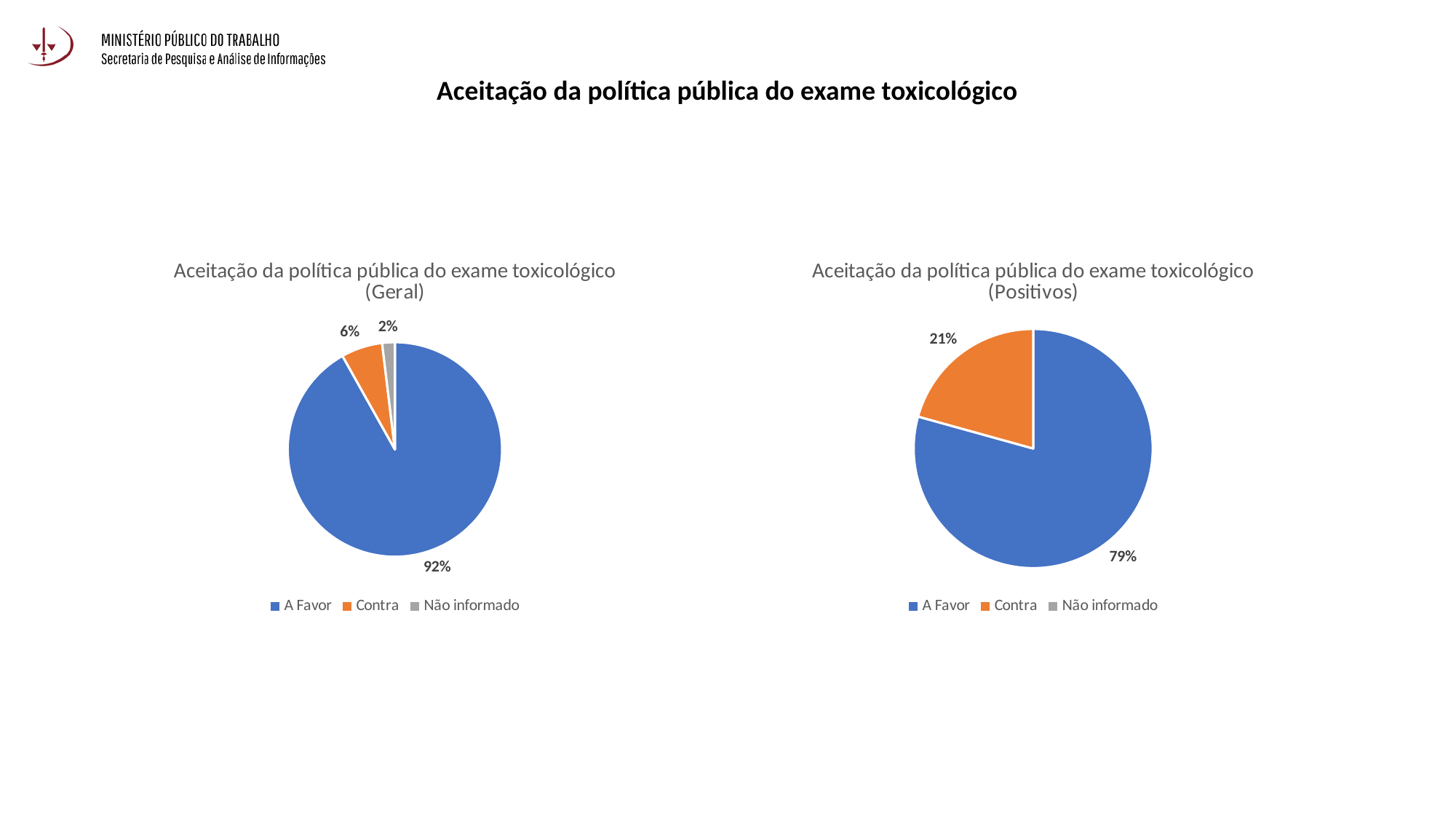
In the 'Aceitação da política pública do exame toxicológico (Positivos)' chart, what is the difference between the A Favor and Contra shares? 58% In the 'Aceitação da política pública do exame toxicológico (Geral)' chart, what share is labelled for Não informado? 2% In the 'Aceitação da política pública do exame toxicológico (Positivos)' chart, what share is labelled for Contra? 21% In the 'Aceitação da política pública do exame toxicológico (Geral)' chart, what share is labelled for Contra? 6% What kind of chart is the 'Aceitação da política pública do exame toxicológico (Geral)' chart? Pie chart How many entries does the legend of the 'Aceitação da política pública do exame toxicológico (Positivos)' chart list? 3 In the 'Aceitação da política pública do exame toxicológico (Geral)' chart, what share is labelled for A Favor? 92% Is the Contra share larger in the (Geral) chart or in the (Positivos) chart? Positivos What is the difference between the A Favor share in the (Geral) chart and the A Favor share in the (Positivos) chart? 13% In the 'Aceitação da política pública do exame toxicológico (Positivos)' chart, what share is labelled for A Favor? 79% In the 'Aceitação da política pública do exame toxicológico (Geral)' chart, which category has the largest slice? A Favor In the 'Aceitação da política pública do exame toxicológico (Geral)' chart, which labelled category has the smallest slice? Não informado